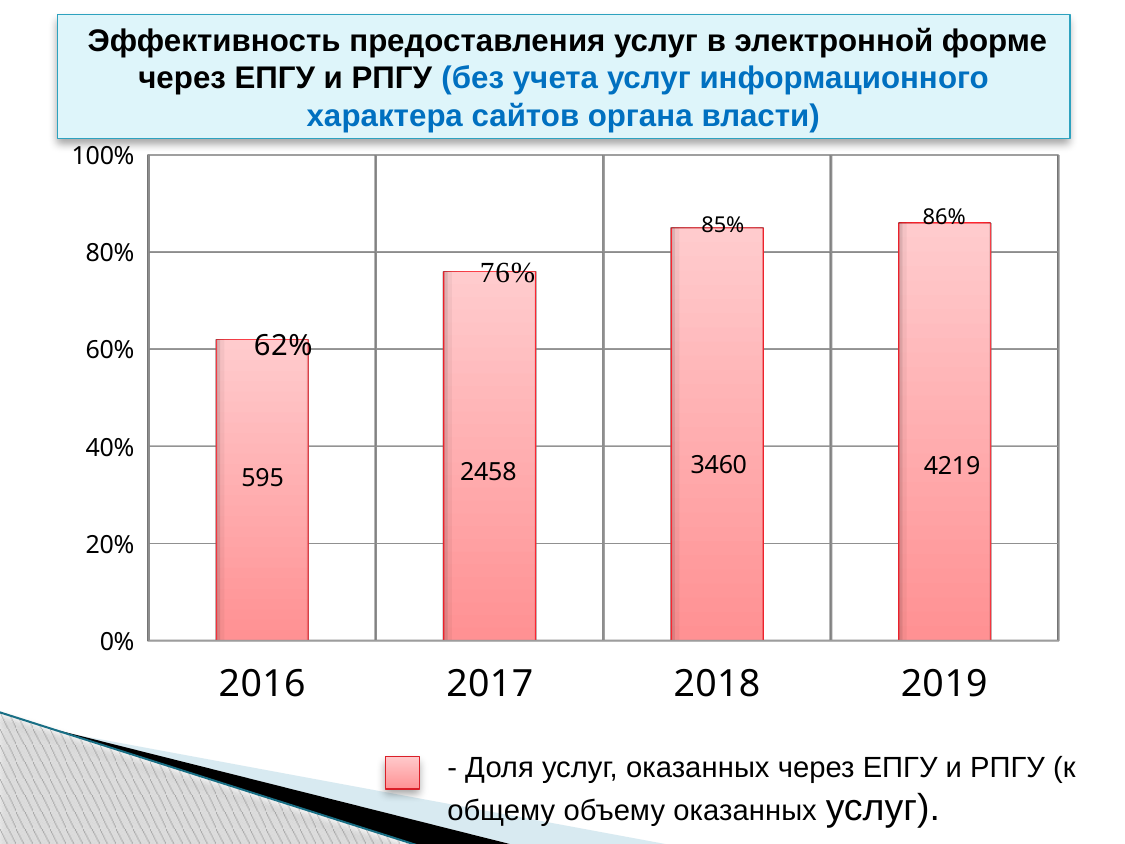
Which year has the lowest percentage value? 2016 How many years are shown on the x axis? 4 What is the difference between the percentage values for 2017 and 2016? 14% Do the percentage values rise or fall from 2016 to 2019? Rise What number is printed inside the bar for 2018? 3460 What is the value shown for 2019? 86% Which year has the highest percentage value? 2019 How many series does the legend list? 1 What is the value shown for 2017? 76% What number is printed inside the bar for 2016? 595 What kind of chart is shown on the slide? Bar chart Which is larger, the percentage value for 2018 or for 2017? 2018